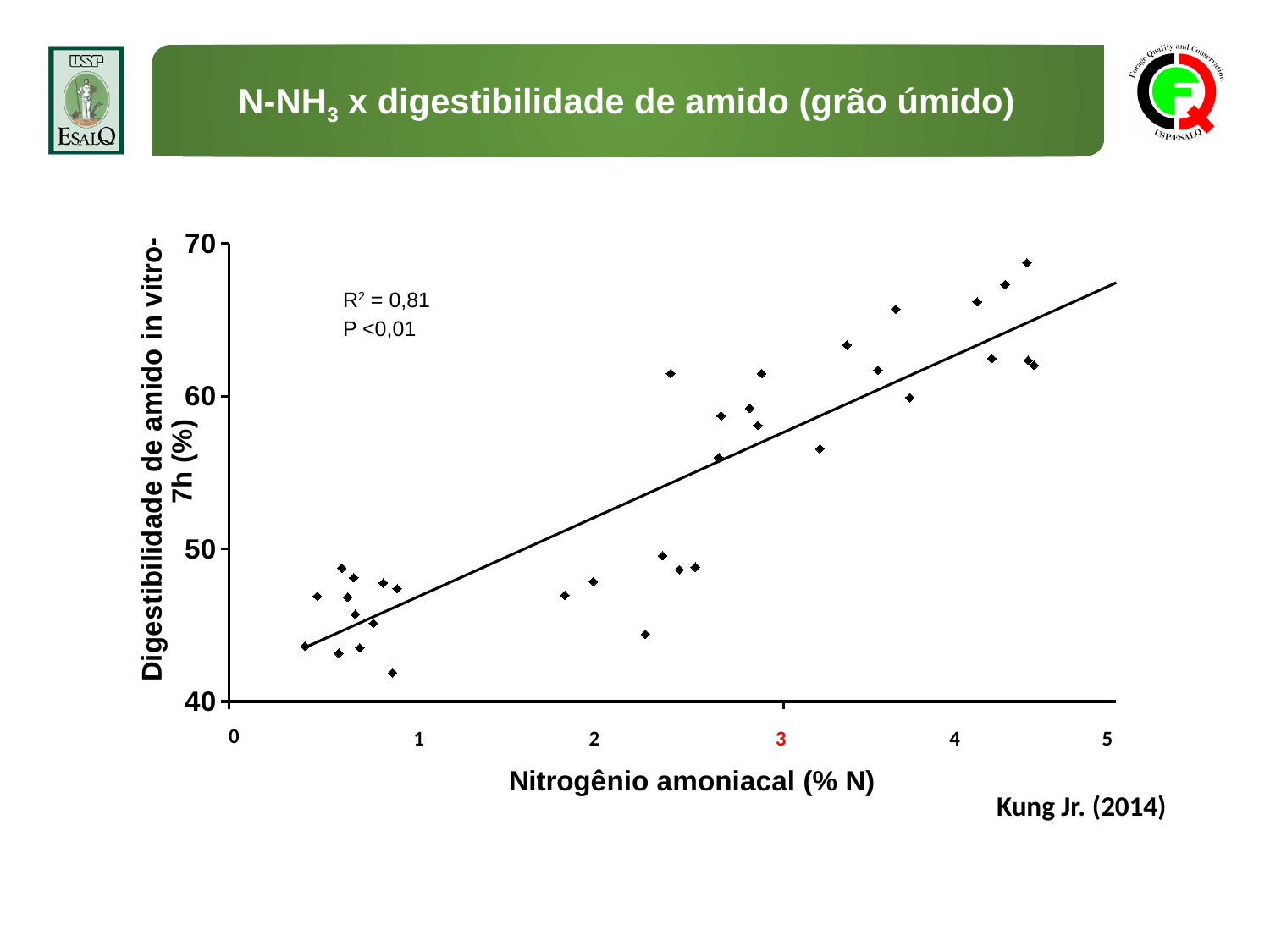
What R² value is printed on the chart? R² = 0,81 What is the maximum value shown on the x axis? 5 Is the lowest plotted digestibility value greater or less than 45? less What is the maximum value shown on the y axis? 70 Is the highest plotted digestibility value greater or less than 65? greater What kind of chart is shown on the slide? scatter chart What P value is printed on the chart? P <0,01 Do the plotted values of starch digestibility rise or fall as ammoniacal nitrogen increases along the x axis? rise